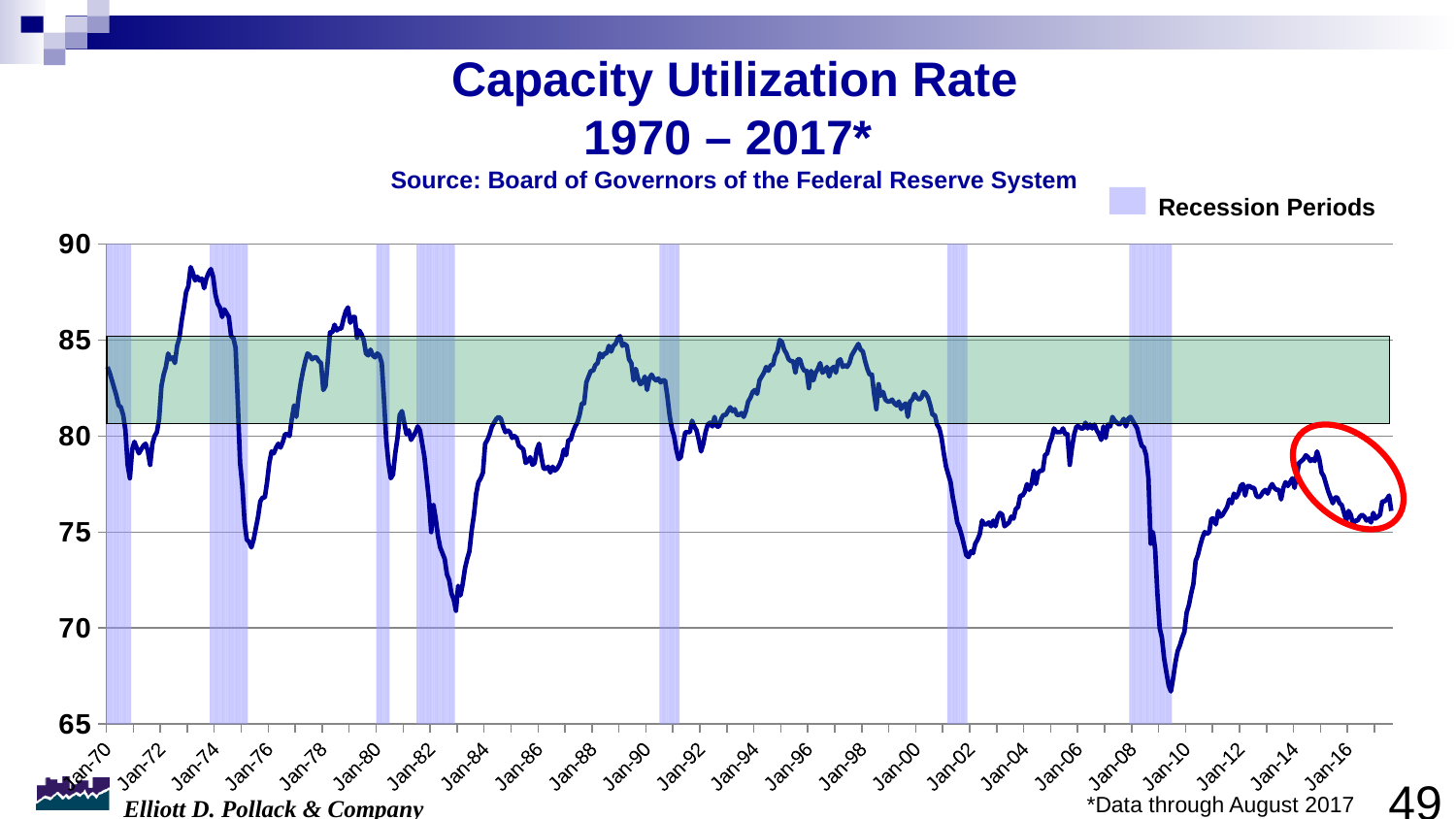
Around which year label does the capacity utilization rate reach its highest point? Jan-74 Around which year label does the capacity utilization rate reach its lowest point? Jan-10 What is the title of the chart? Capacity Utilization Rate 1970 – 2017* What kind of chart is shown on the slide? Line chart How many shaded recession periods are marked on the chart? 7 Does the capacity utilization rate rise or fall between Jan-14 and Jan-16? Fall Which low point is lower: the trough near Jan-82 or the trough near Jan-10? Jan-10 What does the shaded legend entry on the chart represent? Recession Periods Is the capacity utilization rate at Jan-70 greater or less than 80? greater Is the capacity utilization rate at Jan-74 greater or less than 85? greater Is the capacity utilization rate at Jan-16 greater or less than 80? less